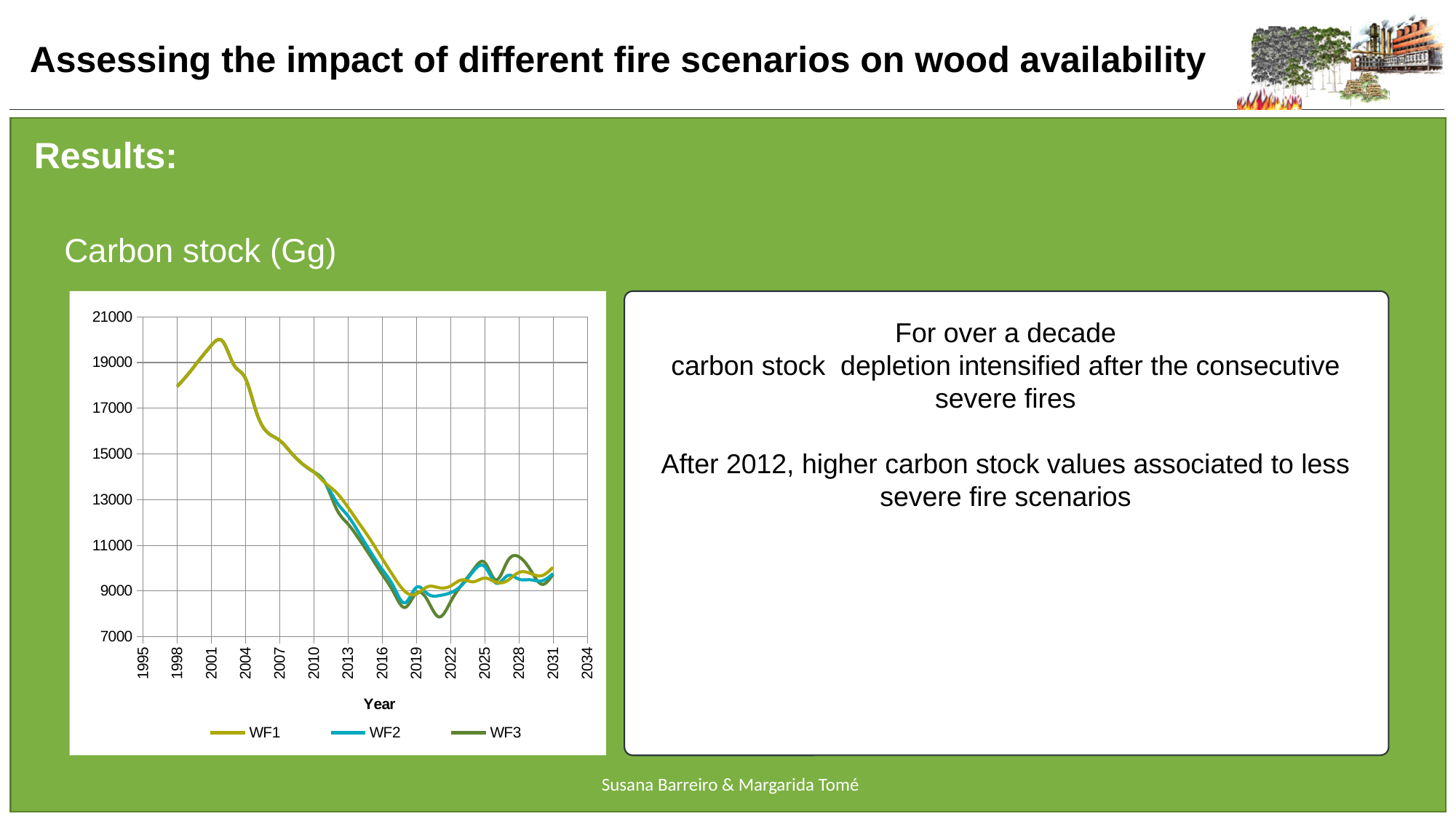
Is the value for WF1 in 2016 greater or less than 11000? less Do the carbon stock values rise or fall between 2001 and 2018? fall How many series does the legend of the chart list? 3 Is the value for WF1 in 2001 greater or less than 19000? greater What type of chart is shown on the slide? line chart Which series has the lowest value around 2021? WF3 What is the title of the x axis of the chart? Year Is the value for WF1 in 2010 greater or less than 13000? greater In 2013, which series has the larger value, WF1 or WF3? WF1 Which series has the highest value around 2028? WF3 What are the names of the series in the chart's legend? WF1, WF2, WF3